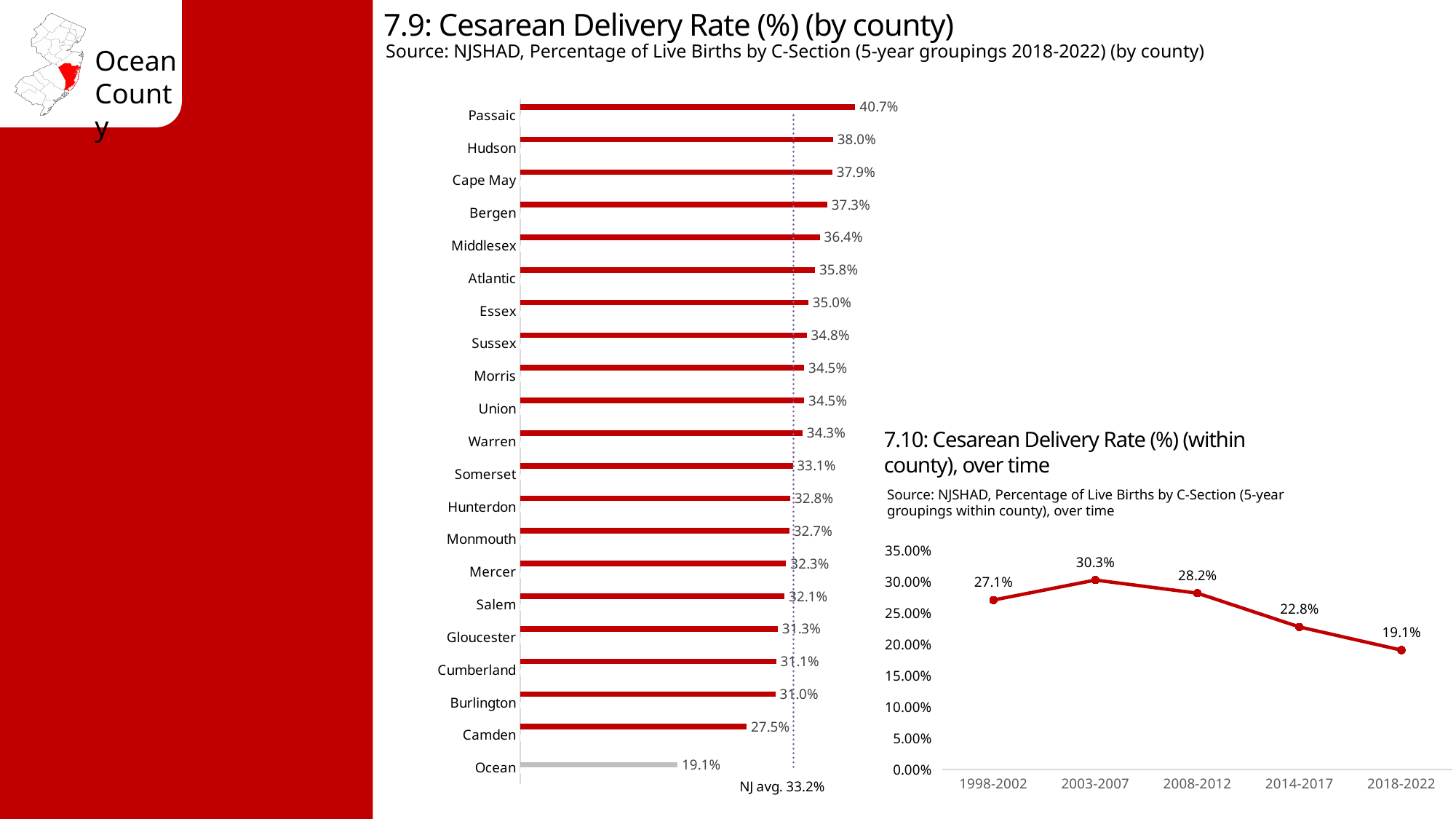
In the 7.9 Cesarean Delivery Rate (by county) chart, what is the value for Passaic? 40.7% In the 7.9 Cesarean Delivery Rate (by county) chart, which county has the highest rate? Passaic What kind of chart is the 7.9 Cesarean Delivery Rate (by county) chart? Bar chart In the 7.9 Cesarean Delivery Rate (by county) chart, what is the difference between Passaic and Ocean? 21.6% In the 7.9 Cesarean Delivery Rate (by county) chart, which county has the lowest rate? Ocean How many counties are shown in the 7.9 Cesarean Delivery Rate (by county) chart? 21 In the 7.9 Cesarean Delivery Rate (by county) chart, what is the value for Ocean? 19.1% In the 7.9 Cesarean Delivery Rate (by county) chart, what NJ average is marked by the dotted line? 33.2% In the 7.10 Cesarean Delivery Rate (within county) over time chart, how many time periods are plotted? 5 In the 7.10 Cesarean Delivery Rate (within county) over time chart, what is the difference between 1998-2002 and 2018-2022? 8.0% In the 7.10 Cesarean Delivery Rate (within county) over time chart, what is the value for 2003-2007? 30.3% In the 7.9 Cesarean Delivery Rate (by county) chart, which is larger, Camden or Burlington? Burlington